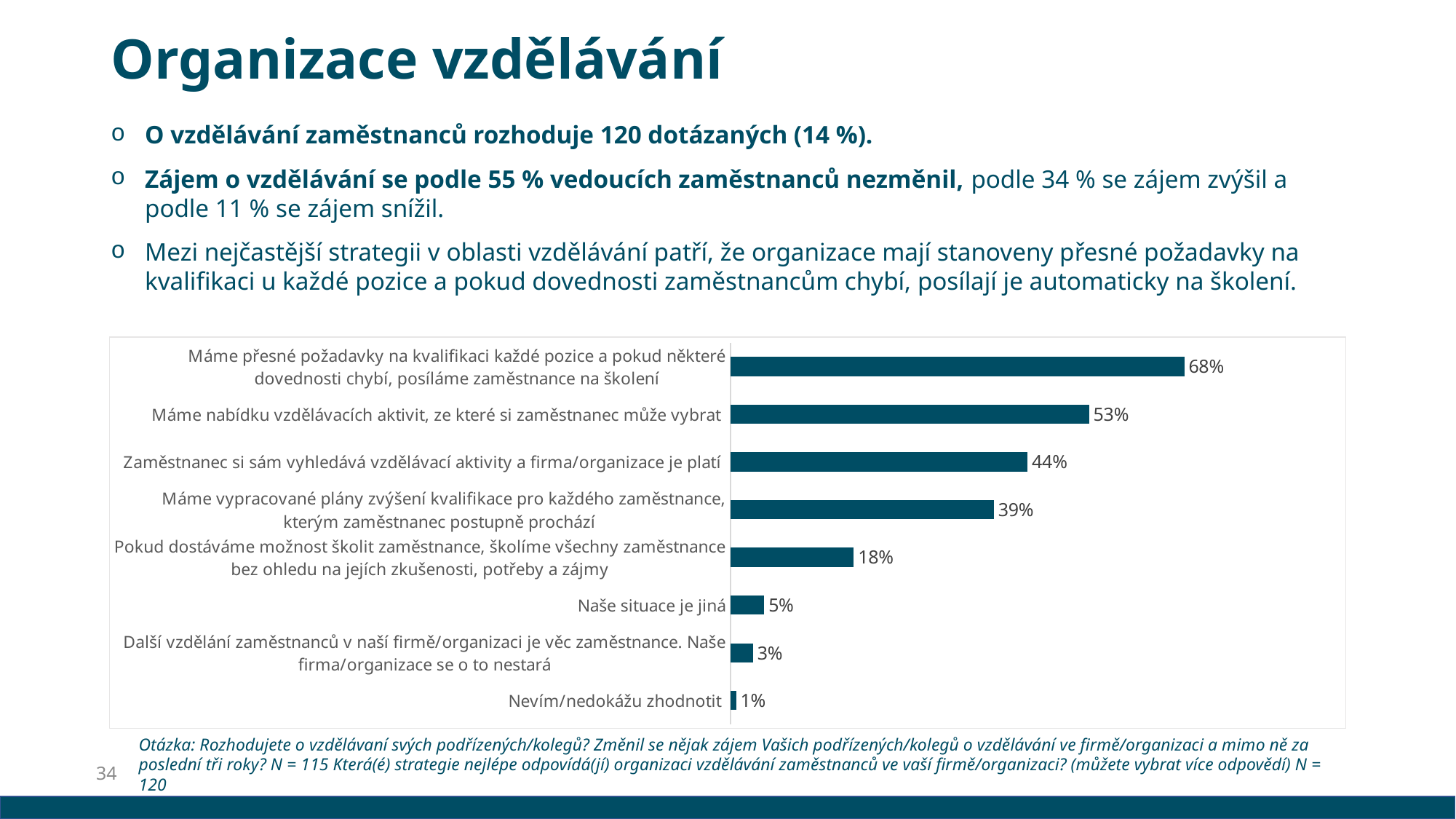
What value is shown for "Máme nabídku vzdělávacích aktivit, ze které si zaměstnanec může vybrat"? 53% What is the difference between the values for "Máme přesné požadavky na kvalifikaci každé pozice..." and "Máme nabídku vzdělávacích aktivit..."? 15% Which category has the highest value? Máme přesné požadavky na kvalifikaci každé pozice a pokud některé dovednosti chybí, posíláme zaměstnance na školení What is the difference between the values for "Máme vypracované plány zvýšení kvalifikace..." and "Pokud dostáváme možnost školit zaměstnance..."? 21% Which category has the lowest value? Nevím/nedokážu zhodnotit What colour are the bars in the chart? Dark teal What value is shown for "Naše situace je jiná"? 5% What value is shown for "Zaměstnanec si sám vyhledává vzdělávací aktivity a firma/organizace je platí"? 44% How many categories are shown in the chart? 8 What kind of chart is shown on the slide? Bar chart Which is larger: the value for "Zaměstnanec si sám vyhledává vzdělávací aktivity..." or for "Máme vypracované plány zvýšení kvalifikace..."? Zaměstnanec si sám vyhledává vzdělávací aktivity a firma/organizace je platí What value is shown for "Další vzdělání zaměstnanců v naší firmě/organizaci je věc zaměstnance. Naše firma/organizace se o to nestará"? 3%